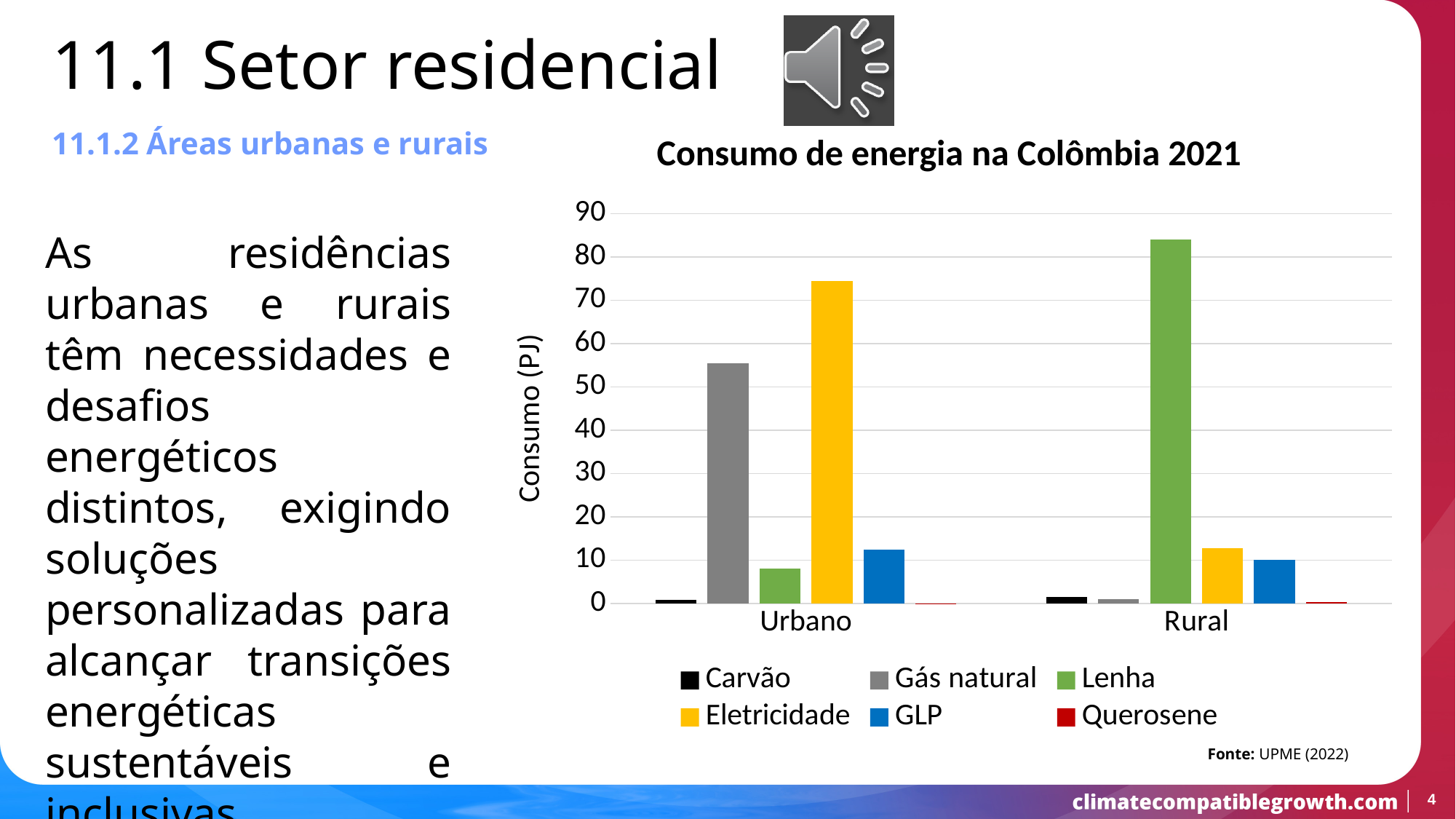
Is the value for GLP in the Rural category greater or less than 20? less What is the title of the chart? Consumo de energia na Colômbia 2021 What kind of chart is shown on the slide? bar chart Is the value for Lenha in the Rural category greater or less than 80? greater How many series does the chart legend list? 6 Which is larger: Gás natural in the Urbano category or Gás natural in the Rural category? Urbano Is the value for Gás natural in the Urbano category greater or less than 50? greater Which is larger: Lenha in the Urbano category or Lenha in the Rural category? Rural How many categories are shown on the x axis of the chart? 2 Which series has the highest value in the Rural category? Lenha Which series has the highest value in the Urbano category? Eletricidade